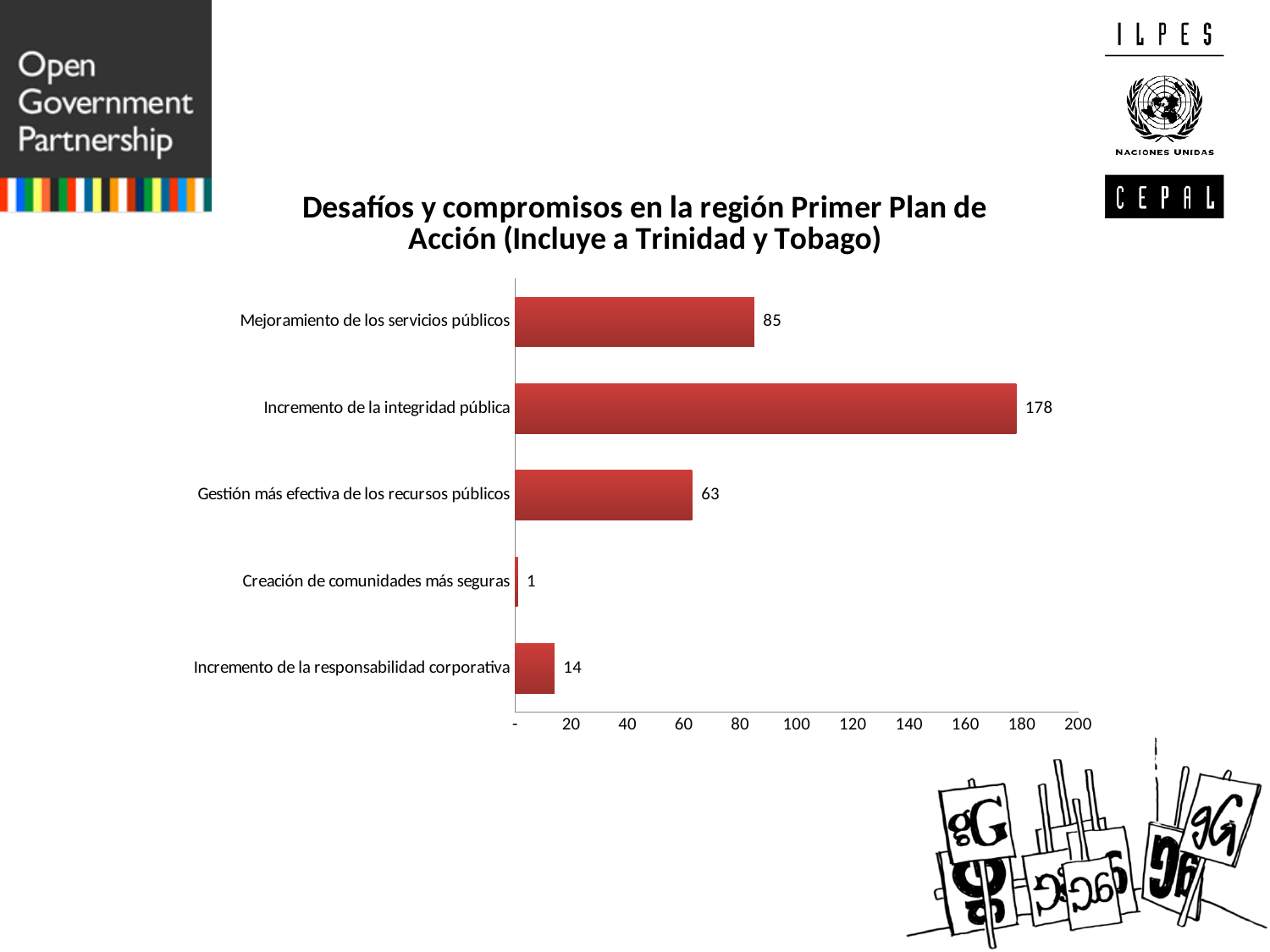
What kind of chart is shown on the slide? bar chart Which category has the lowest value? Creación de comunidades más seguras Which is larger, the value for Gestión más efectiva de los recursos públicos or the value for Incremento de la responsabilidad corporativa? Gestión más efectiva de los recursos públicos What is the difference between the values for Incremento de la integridad pública and Mejoramiento de los servicios públicos? 93 What is the title of the chart? Desafíos y compromisos en la región Primer Plan de Acción (Incluye a Trinidad y Tobago) What is the value for Incremento de la responsabilidad corporativa? 14 Is the value for Mejoramiento de los servicios públicos greater or less than 100? less What is the value for Mejoramiento de los servicios públicos? 85 Which category has the highest value? Incremento de la integridad pública What is the value for Incremento de la integridad pública? 178 How many categories are shown in the chart? 5 What is the value for Gestión más efectiva de los recursos públicos? 63